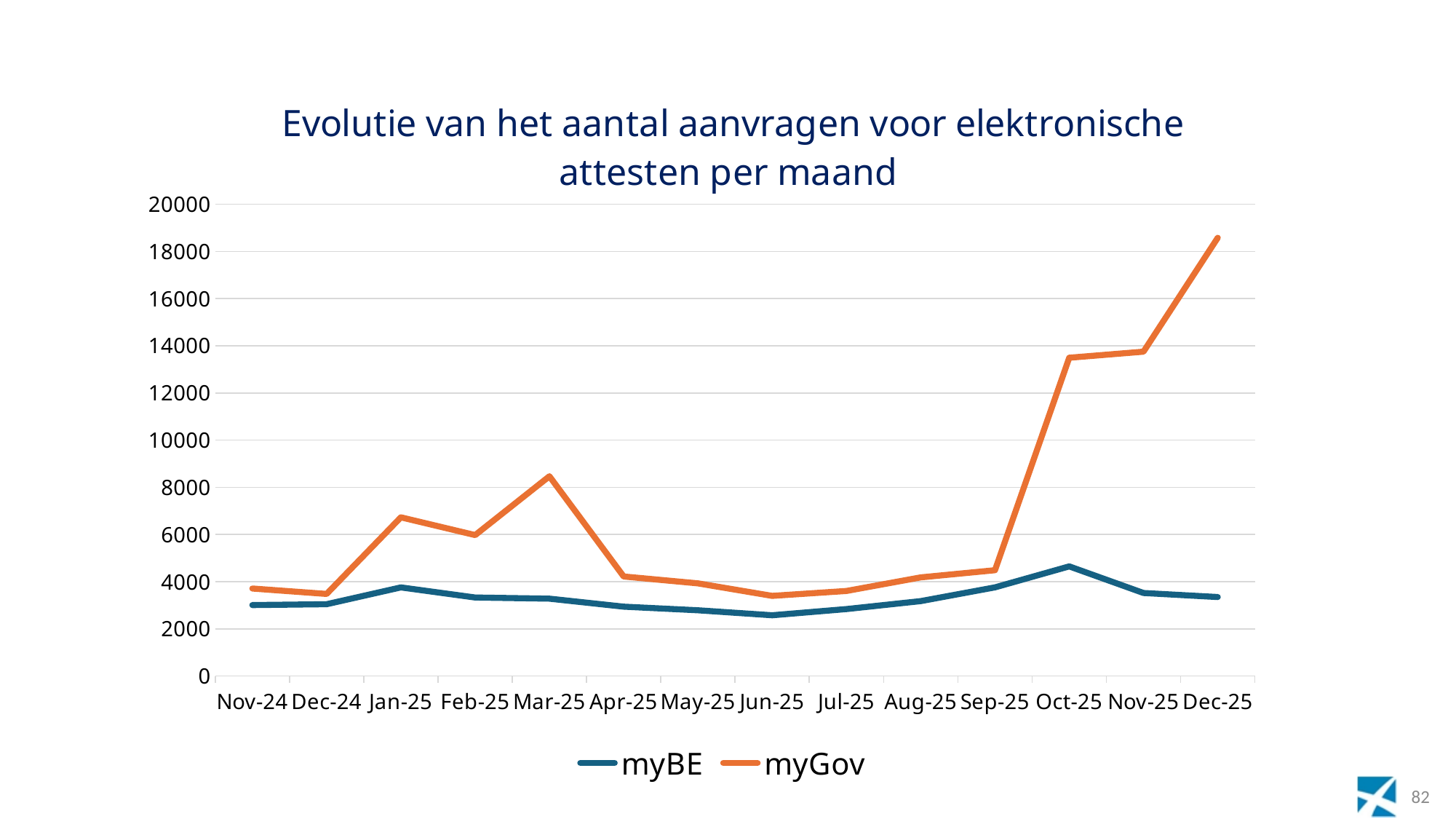
In which month does the myGov series reach its highest value? Dec-25 In which month does the myBE series reach its lowest value? Jun-25 How many months are plotted along the x axis? 14 Is the value for myGov in Oct-25 greater or less than 12000? greater Which series has the larger value in Mar-25, myBE or myGov? myGov What is the title of the chart? Evolutie van het aantal aanvragen voor elektronische attesten per maand Does the myGov series rise or fall from Sep-25 to Dec-25? rise Is the value for myBE in Jun-25 greater or less than 4000? less In which month does the myBE series reach its highest value? Oct-25 Is the value for myGov in Dec-25 greater or less than 16000? greater How many series does the legend list? 2 What kind of chart is shown on the slide? line chart